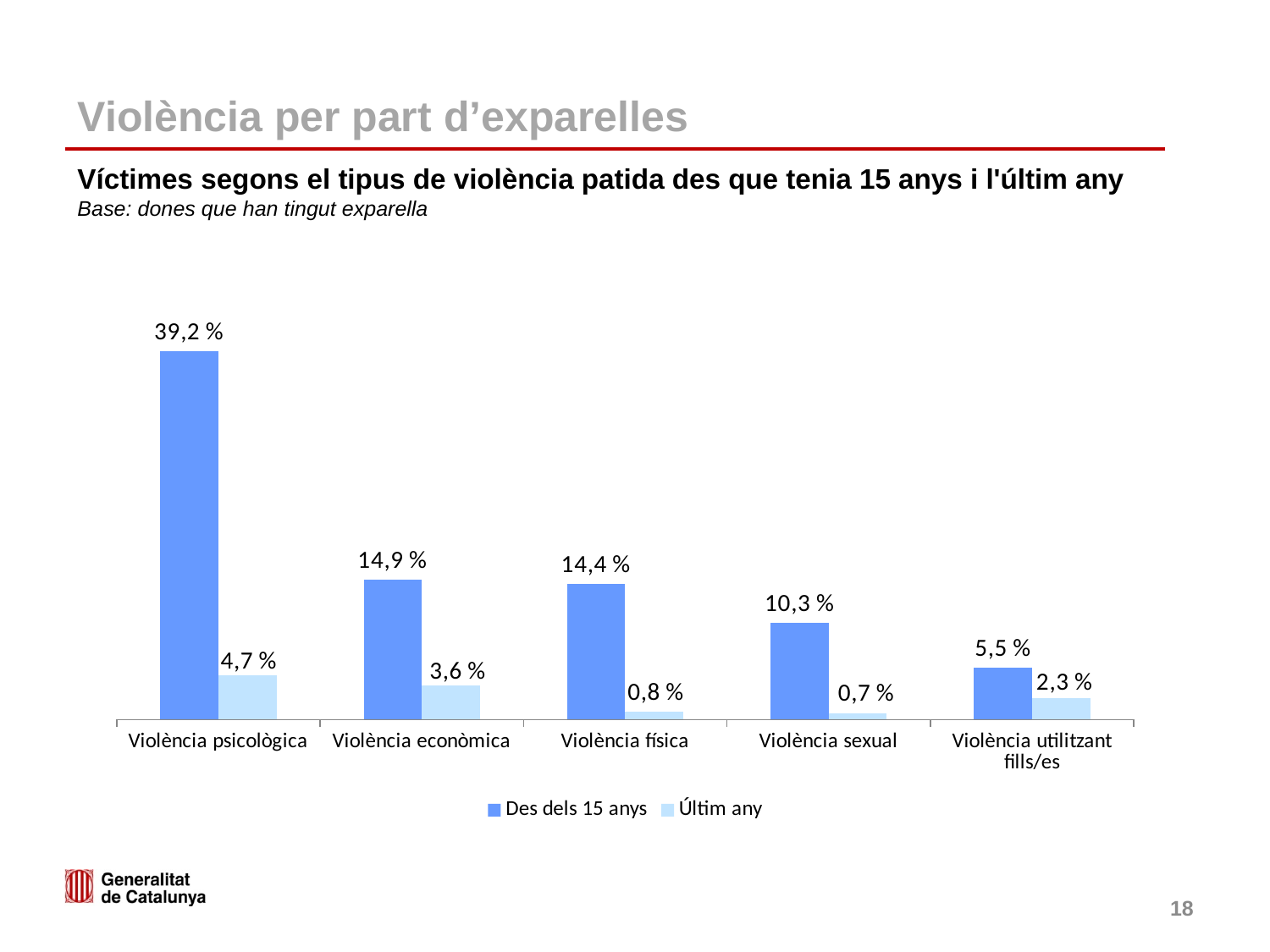
Do the 'Des dels 15 anys' values rise or fall from left to right along the x axis? Fall Which category has the lowest value in the 'Últim any' series? Violència sexual What is the value for Violència utilitzant fills/es in the 'Des dels 15 anys' series? 5,5 % What is the difference between the 'Des dels 15 anys' and 'Últim any' values for Violència econòmica? 11,3 % What is the value for Violència psicològica in the 'Des dels 15 anys' series? 39,2 % How many categories are shown on the x axis? 5 What is the value for Violència física in the 'Últim any' series? 0,8 % What are the two series named in the legend? Des dels 15 anys; Últim any What kind of chart is shown on the slide? Bar chart Which category has the highest value in the 'Des dels 15 anys' series? Violència psicològica Which is larger: the 'Des dels 15 anys' value for Violència econòmica or for Violència física? Violència econòmica How many series does the legend list? 2